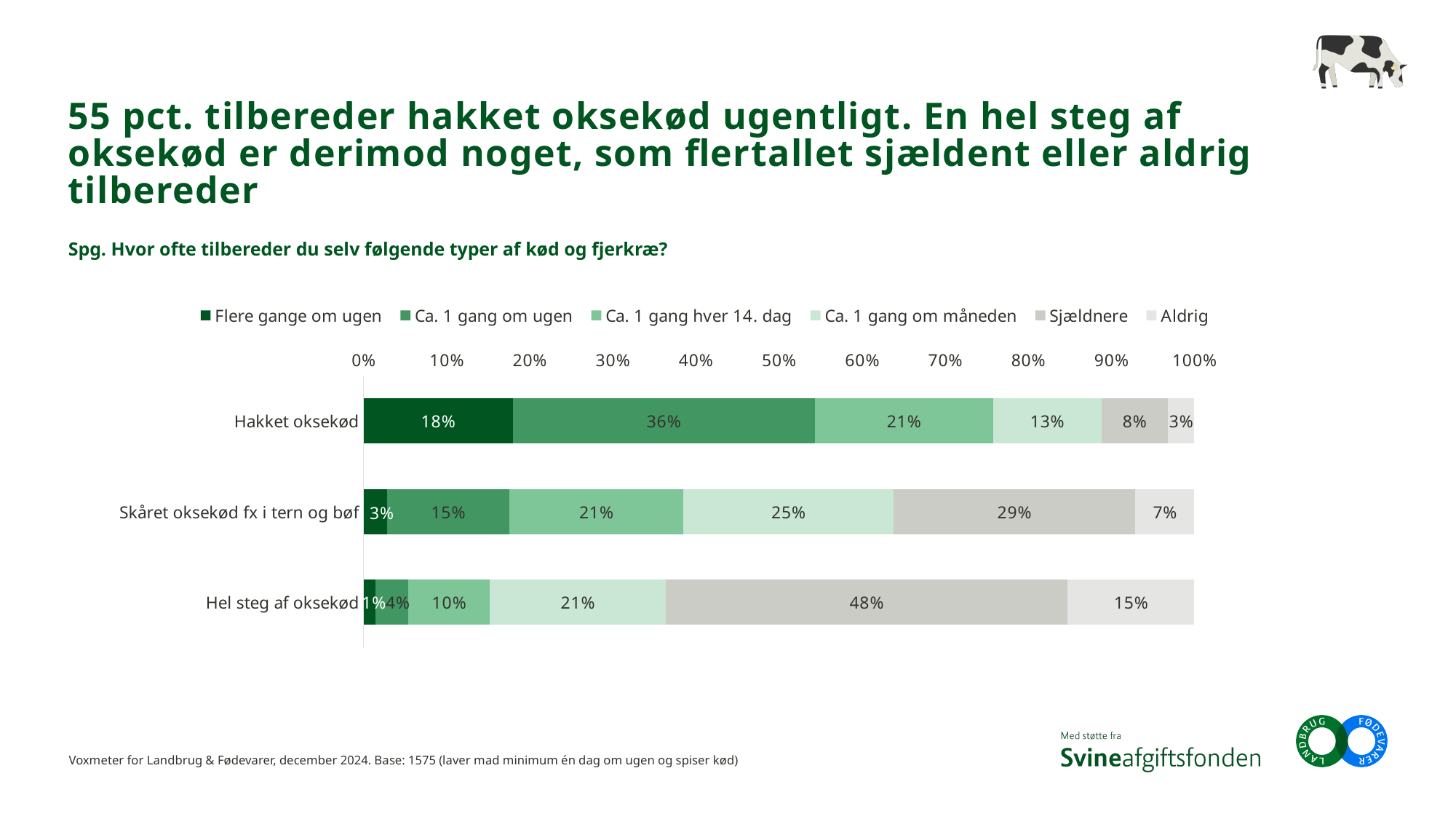
What is the value for 'Ca. 1 gang om måneden' for Skåret oksekød fx i tern og bøf? 25% Which category has the highest value for 'Flere gange om ugen'? Hakket oksekød What is the value for 'Aldrig' for Hel steg af oksekød? 15% What is the difference between the 'Sjældnere' values for Hel steg af oksekød and Skåret oksekød fx i tern og bøf? 19 percentage points How many series does the legend list? 6 What is the first entry listed in the chart legend? Flere gange om ugen What kind of chart is shown on the slide? stacked bar chart What is the value for 'Ca. 1 gang om ugen' for Hakket oksekød? 36% Which category has the lowest value for 'Sjældnere'? Hakket oksekød How many categories (types of meat) are plotted on the chart? 3 Which is larger: the 'Aldrig' value for Skåret oksekød fx i tern og bøf or for Hakket oksekød? Skåret oksekød fx i tern og bøf What is the value for 'Sjældnere' for Hel steg af oksekød? 48%